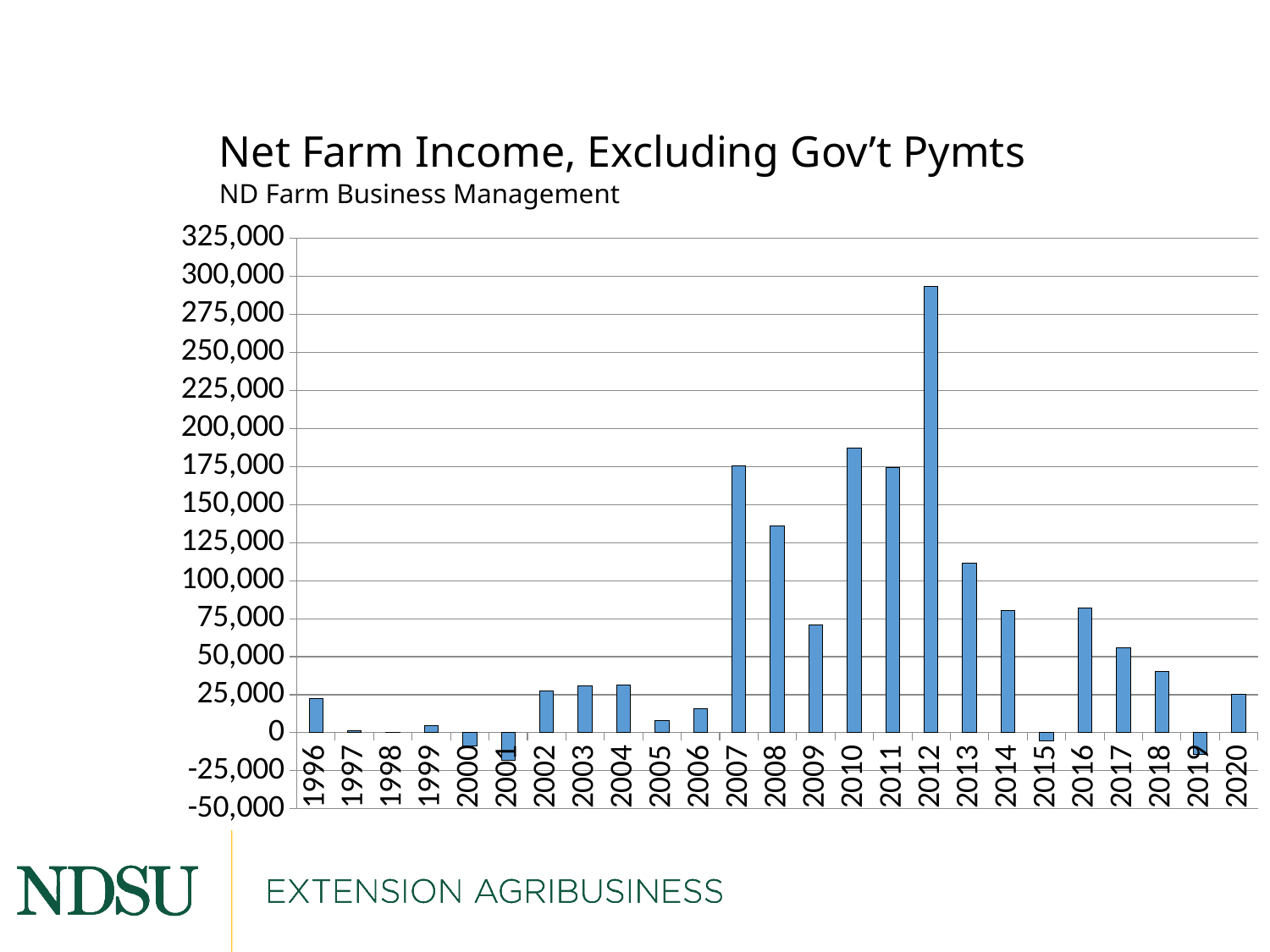
Do the values rise or fall from 2016 to 2019? fall Is the value for 2008 greater or less than 125,000? greater Is the value for 2013 greater or less than 100,000? greater Which year has the larger value, 2008 or 2013? 2008 Which year has the larger value, 2010 or 2011? 2010 How many years are plotted on the x axis? 25 Is the value for 2018 greater or less than 50,000? less What is the title of the chart? Net Farm Income, Excluding Gov’t Pymts Which year has the highest net farm income? 2012 What kind of chart is shown on the slide? bar chart